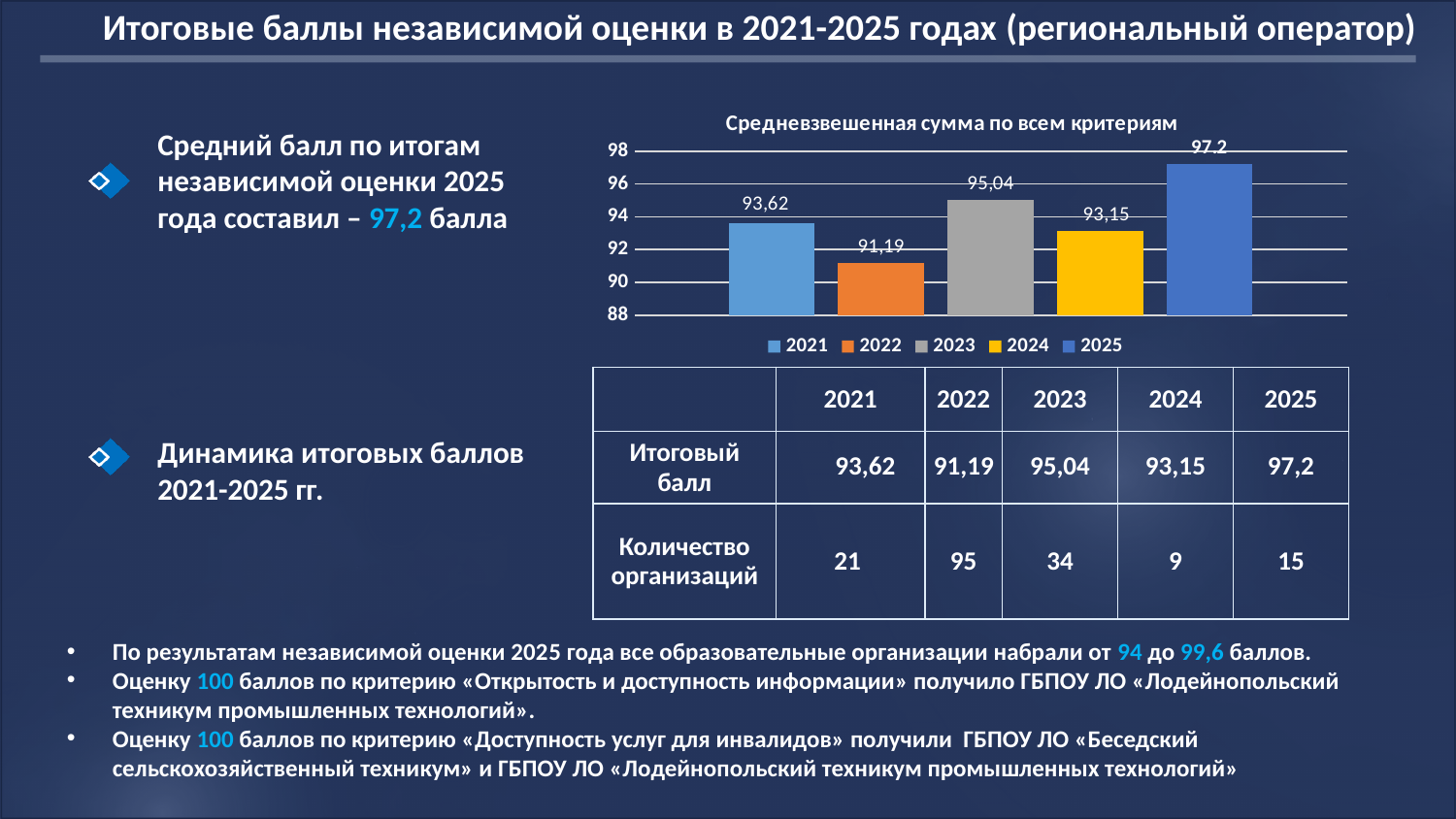
Which is larger, the value for 2023 or the value for 2024? 2023 Is the value for 2024 greater or less than 92? greater What is the difference between the values for 2025 and 2022? 6,01 What type of chart is shown on the slide? bar chart Which year has the highest value in the chart? 2025 How many bars are shown in the chart? 5 What is the difference between the values for 2023 and 2021? 1,42 What is the value for 2025 in the chart? 97,2 What is the title of the chart? Средневзвешенная сумма по всем критериям What is the value for 2021 in the chart? 93,62 What is the value for 2022 in the chart? 91,19 Which year has the lowest value in the chart? 2022